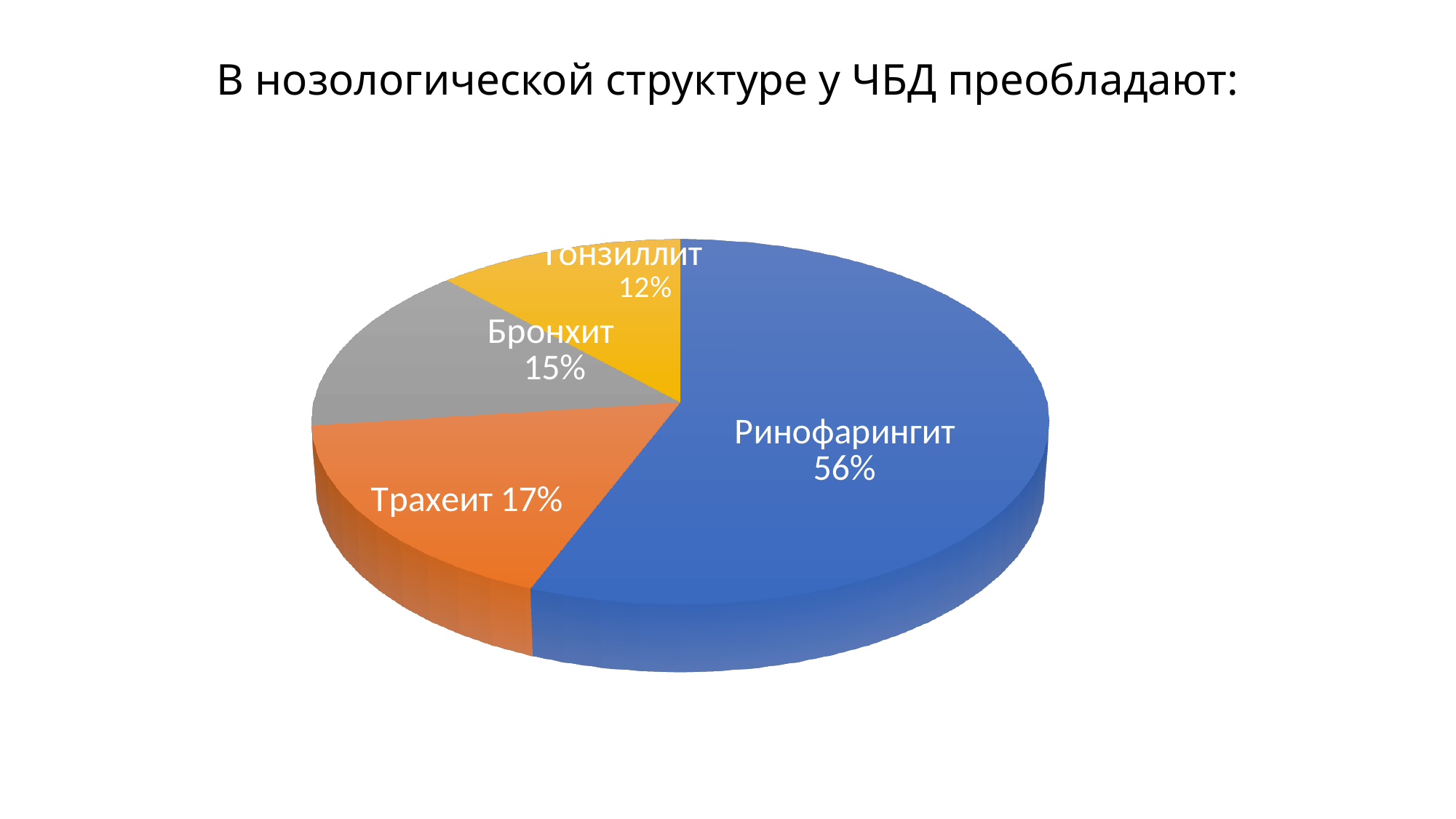
What is the share for Тонзиллит? 12% Which is larger, the share for Бронхит or the share for Тонзиллит? Бронхит How many slices does the pie chart have? 4 What is the difference in percentage points between Ринофарингит and Трахеит? 39 What colour is the slice for Ринофарингит? blue What is the share for Трахеит? 17% What kind of chart is shown on the slide? pie chart What is the difference in percentage points between Трахеит and Бронхит? 2 What is the share for Ринофарингит? 56% Which category has the smallest slice of the pie? Тонзиллит Which category has the largest slice of the pie? Ринофарингит What is the share for Бронхит? 15%